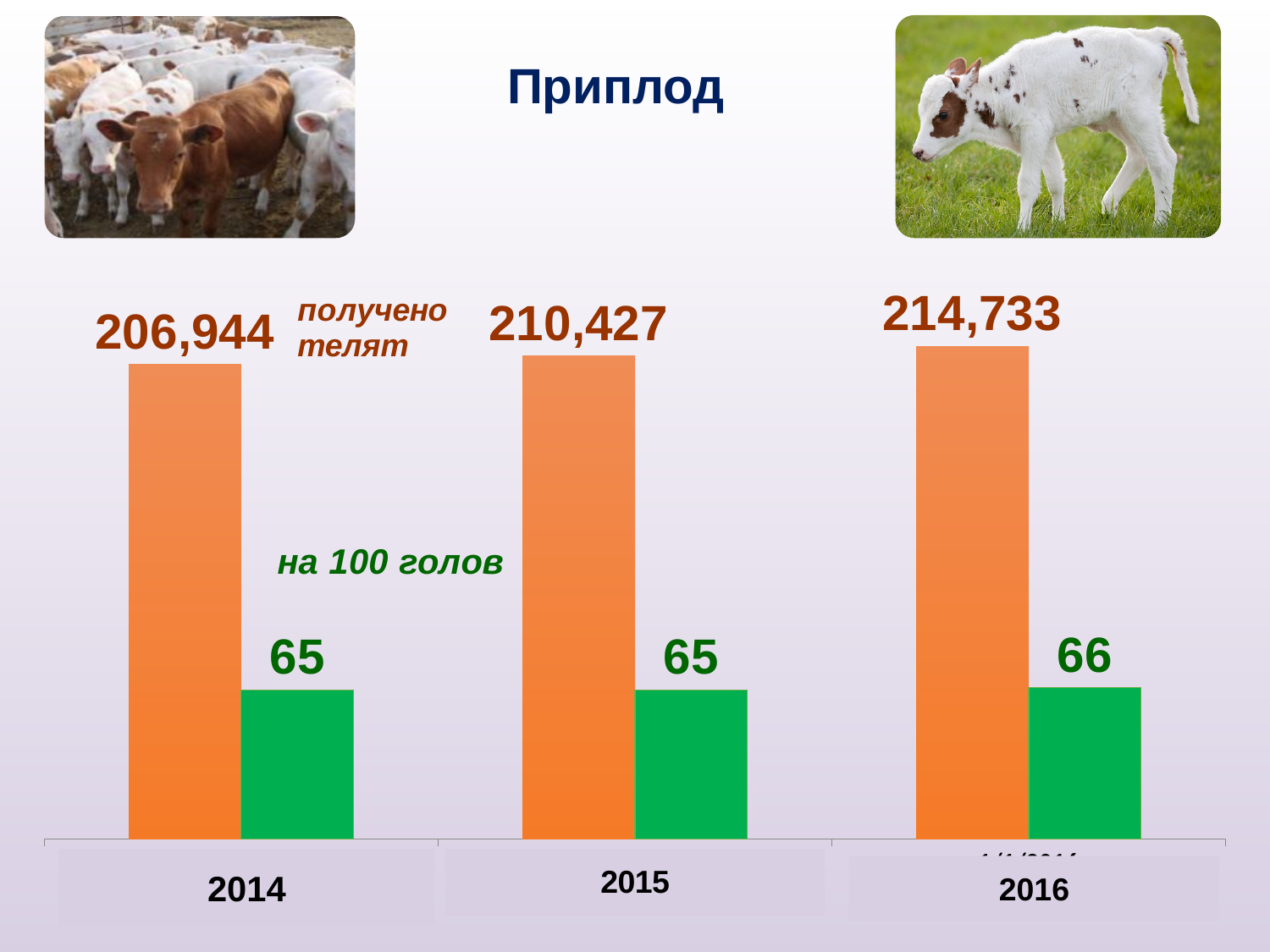
What is the value of 'получено телят' for 2014? 206,944 Which year has the lowest value of 'получено телят'? 2014 What is the value of 'получено телят' for 2016? 214,733 What type of chart is shown on the slide? bar chart Which year has the highest value of 'получено телят'? 2016 What is the difference in 'получено телят' between 2016 and 2014? 7,789 Which is larger: 'получено телят' in 2015 or in 2014? 2015 What is the title of the chart? Приплод Do the 'получено телят' values rise or fall from 2014 to 2016? rise How many years are shown on the x axis of the chart? 3 What is the value of 'получено телят' for 2015? 210,427 What is the value 'на 100 голов' for 2016? 66